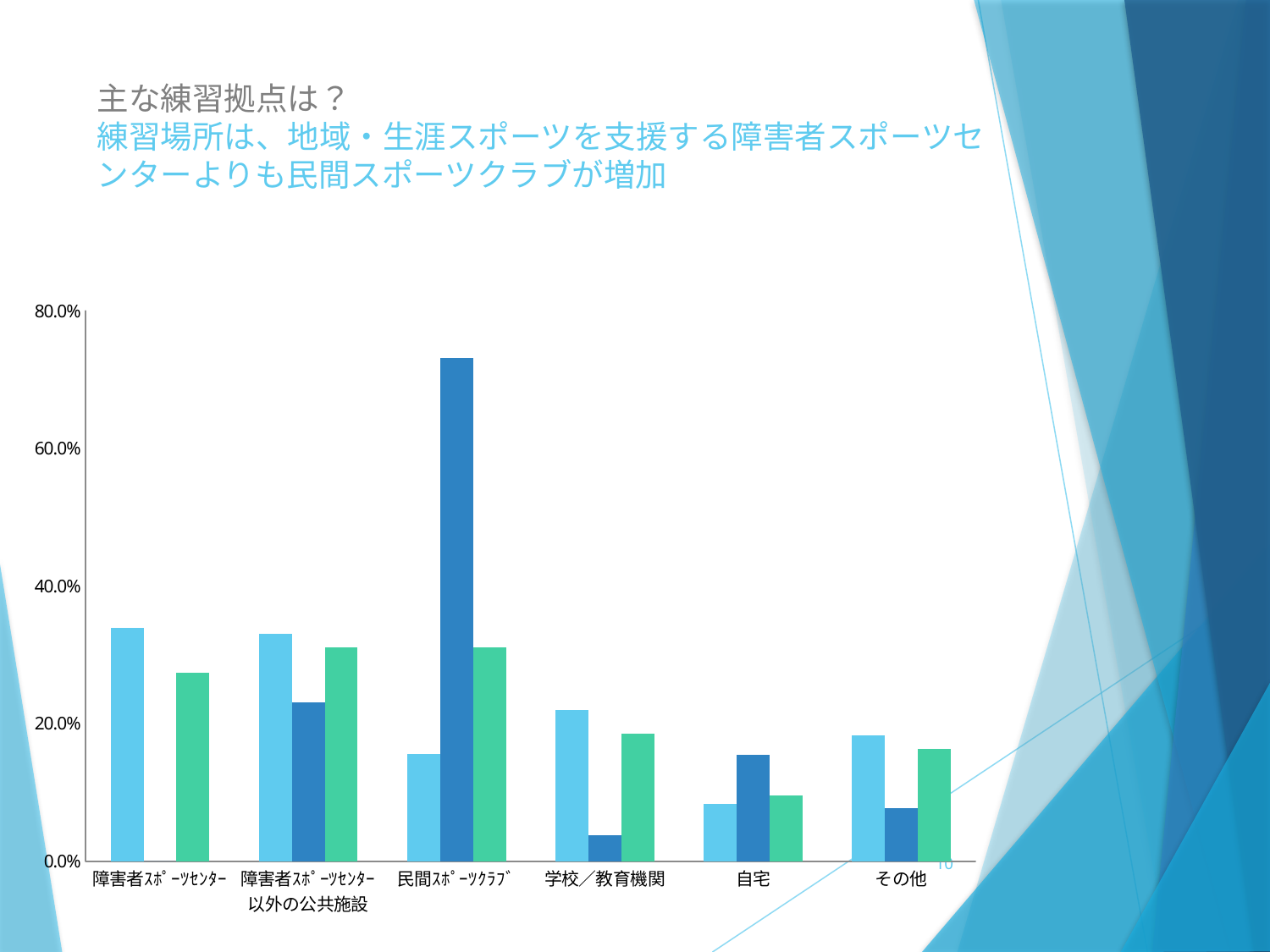
What kind of chart is shown on the slide? bar chart Which is larger: the light blue bar for 障害者スポーツセンター or the light blue bar for 民間スポーツクラブ? 障害者スポーツセンター Is the light blue bar for 障害者スポーツセンター greater or less than 20.0%? greater Is the light blue bar for 民間スポーツクラブ greater or less than 20.0%? less Which is larger: the green bar for 自宅 or the green bar for その他? その他 Is the green bar for 自宅 greater or less than 20.0%? less Which category has the tallest bar in the chart? 民間スポーツクラブ What is the highest value shown on the y axis of the chart? 80.0% Which category has the lowest bar in the chart? 学校／教育機関 How many categories are shown on the x axis of the chart? 6